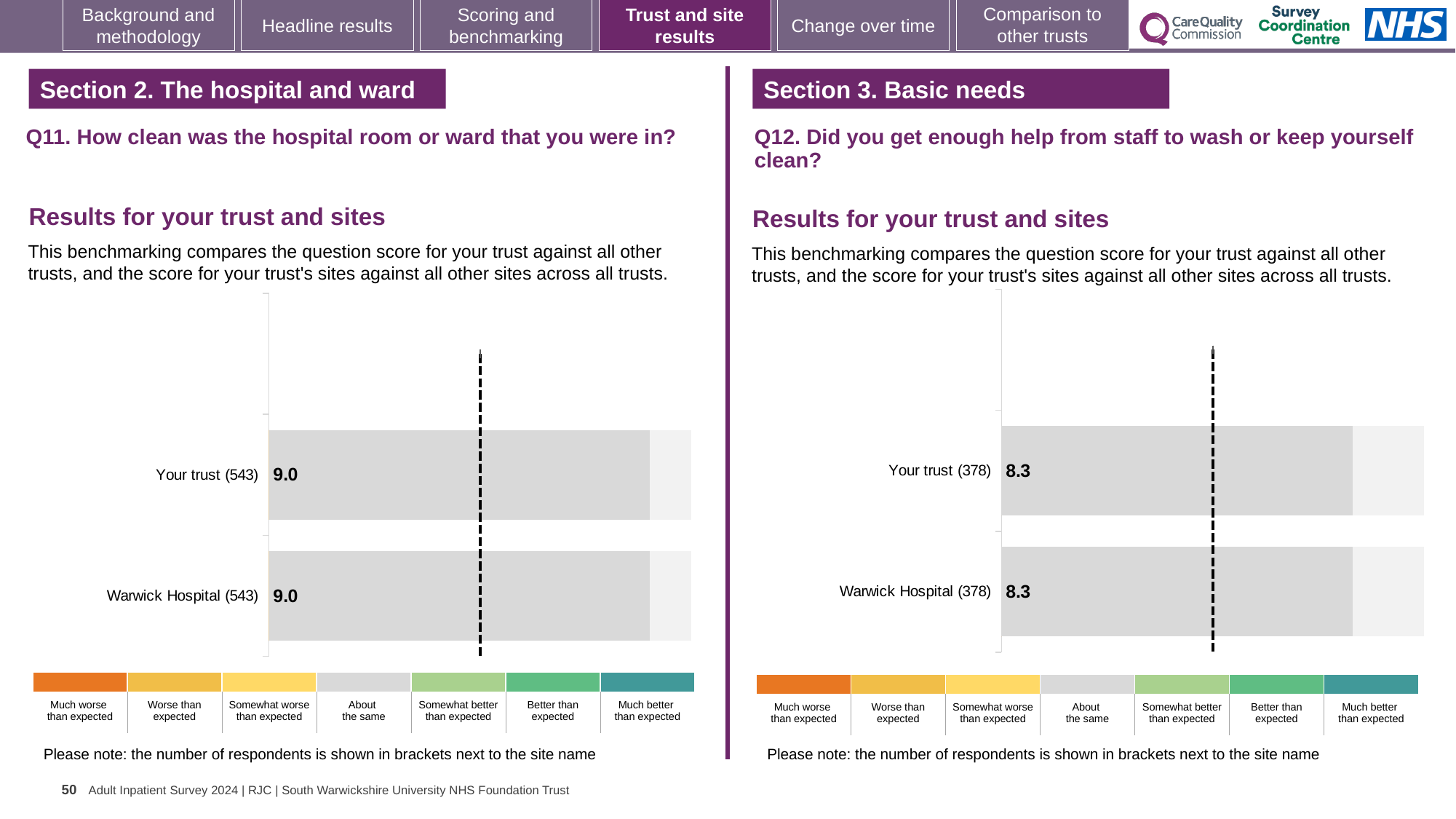
In the Q12 chart on the right, how many respondents are shown in brackets next to Warwick Hospital? 378 In the Q12 chart on the right, what is the score for Your trust? 8.3 In the Q11 chart on the left, what is the score for Your trust? 9.0 In the Q11 chart on the left, what is the difference between the scores for Your trust and Warwick Hospital? 0.0 In the Q11 chart on the left, how many respondents are shown in brackets next to Your trust? 543 In the Q12 chart on the right, what is the score for Warwick Hospital? 8.3 In the Q12 chart on the right, what is the difference between the scores for Your trust and Warwick Hospital? 0.0 How many bars are plotted in the Q11 chart on the left? 2 In the Q11 chart on the left, what is the score for Warwick Hospital? 9.0 Is the score for Your trust in the Q11 chart on the left larger than the score for Your trust in the Q12 chart on the right? Yes How many bars are plotted in the Q12 chart on the right? 2 What kind of chart is used for the Q11 results on the left? Bar chart